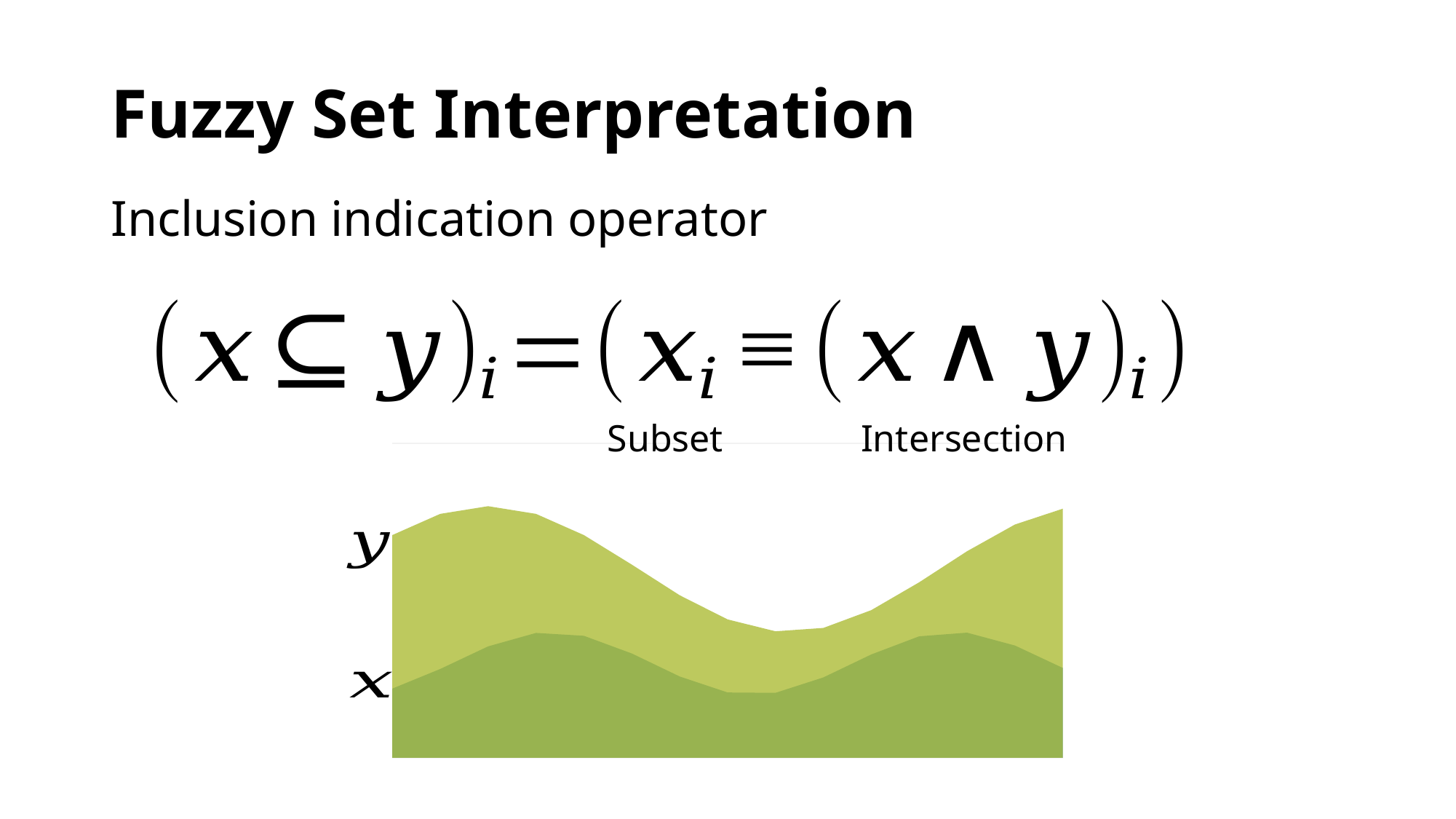
Which series is larger across the whole chart, x or y? y What are the labels of the two series in the area chart? y and x Does the y series rise or fall from the middle of the chart toward the right edge? Rise Which series is drawn in the lighter green colour? y What kind of chart is shown at the bottom of the slide? Area chart How many series are plotted in the area chart? 2 Does the y series fall or rise from its peak near the left toward the middle of the chart? Fall